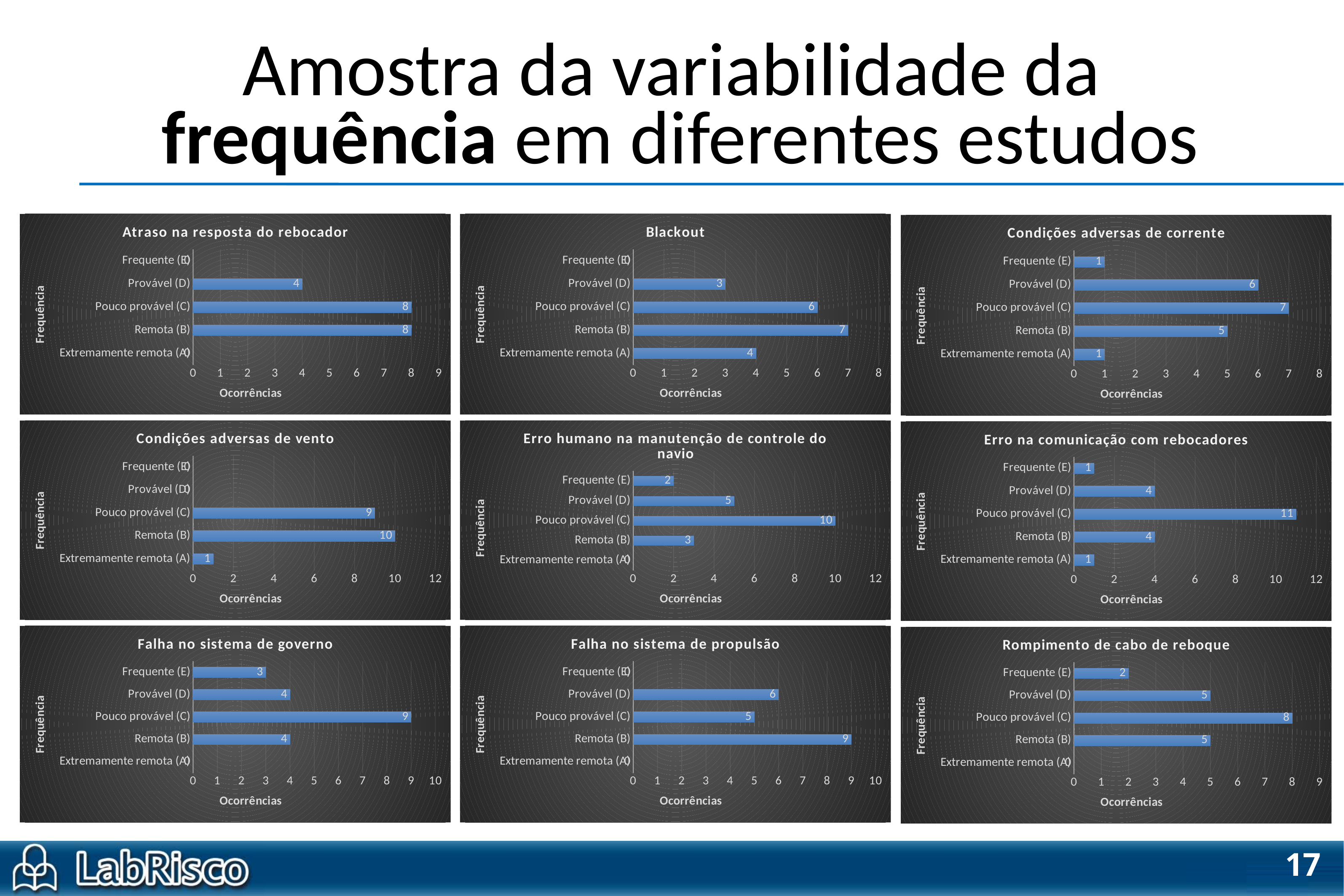
In the 'Falha no sistema de propulsão' chart, which is larger: Provável (D) or Remota (B)? Remota (B) In the 'Condições adversas de vento' chart, what is the value for Remota (B)? 10 In the 'Falha no sistema de governo' chart, what is the value for Frequente (E)? 3 In the 'Erro humano na manutenção de controle do navio' chart, what is the difference between Pouco provável (C) and Provável (D)? 5 In the 'Rompimento de cabo de reboque' chart, what is the value for Pouco provável (C)? 8 How many charts are shown on the slide? 9 In the 'Blackout' chart, what is the value for Remota (B)? 7 In the 'Atraso na resposta do rebocador' chart, what is the value for Provável (D)? 4 How many categories are shown on the y axis of the 'Blackout' chart? 5 In the 'Erro na comunicação com rebocadores' chart, what is the value for Pouco provável (C)? 11 What kind of chart is 'Condições adversas de vento'? Bar chart In the 'Condições adversas de corrente' chart, which category has the highest value? Pouco provável (C)